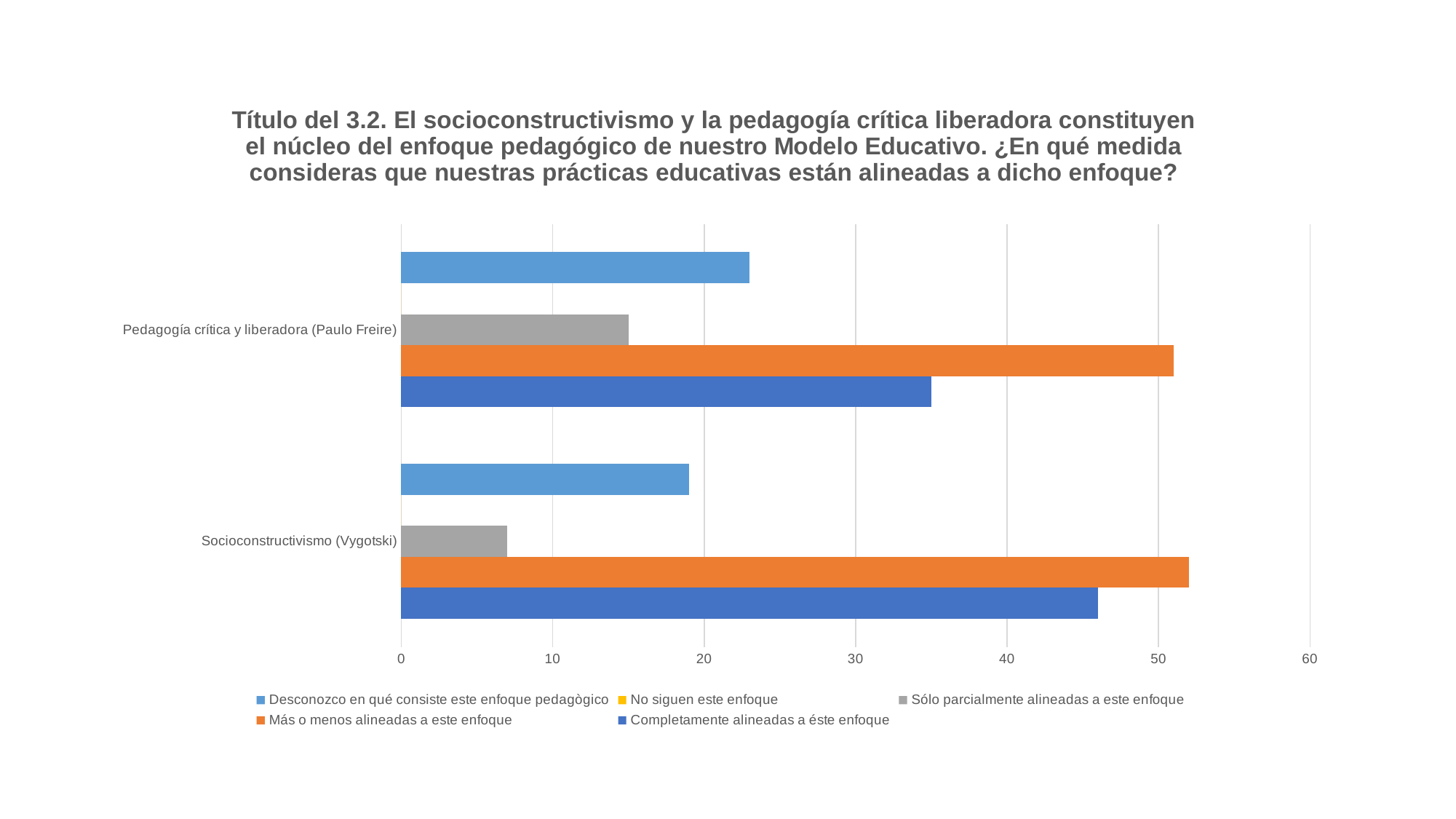
For Socioconstructivismo (Vygotski), which response option has the longest bar? Más o menos alineadas a este enfoque What colour are the bars for 'Más o menos alineadas a este enfoque'? orange Is the value for 'Completamente alineadas a éste enfoque' for Socioconstructivismo (Vygotski) greater or less than 40? greater For Pedagogía crítica y liberadora (Paulo Freire), which response option has the longest bar? Más o menos alineadas a este enfoque How many categories are shown on the vertical axis of the chart? 2 Which category has the larger value for 'Sólo parcialmente alineadas a este enfoque': Pedagogía crítica y liberadora (Paulo Freire) or Socioconstructivismo (Vygotski)? Pedagogía crítica y liberadora (Paulo Freire) Is the value for 'Desconozco en qué consiste este enfoque pedagògico' for Pedagogía crítica y liberadora (Paulo Freire) greater or less than 20? greater Is the value for 'Sólo parcialmente alineadas a este enfoque' for Socioconstructivismo (Vygotski) greater or less than 10? less How many series does the legend list? 5 What kind of chart is shown on the slide? bar chart Which category has the larger value for 'Completamente alineadas a éste enfoque': Pedagogía crítica y liberadora (Paulo Freire) or Socioconstructivismo (Vygotski)? Socioconstructivismo (Vygotski)